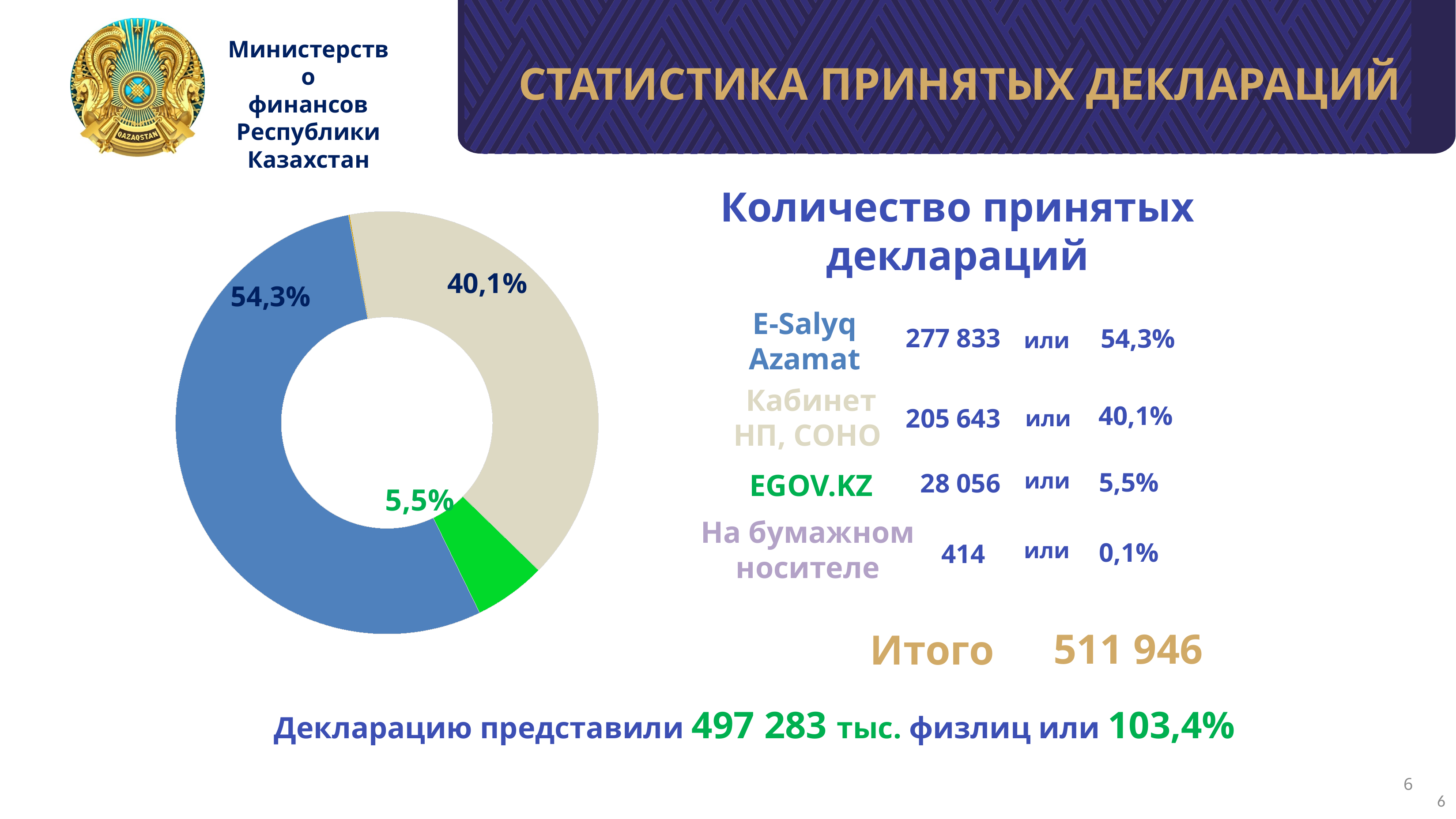
Which is larger in the pie chart: the share for EGOV.KZ or the share for Кабинет НП, СОНО? Кабинет НП, СОНО What share of the pie chart does the blue slice represent? 54,3% What colour is the slice representing E-Salyq Azamat in the pie chart? Blue What is the difference in percentage points between the E-Salyq Azamat share and the Кабинет НП, СОНО share? 14,2 What share of the pie chart does the beige slice represent? 40,1% What share of the pie chart does the green slice represent? 5,5% How many declarations were accepted via EGOV.KZ according to the slide? 28 056 What is the total number of accepted declarations shown next to the pie chart (Итого)? 511 946 Which category has the smallest share in the pie chart? На бумажном носителе What kind of chart is shown on the left of the slide? Pie chart (donut) How many slices does the pie chart have? 4 Which category has the largest share in the pie chart? E-Salyq Azamat